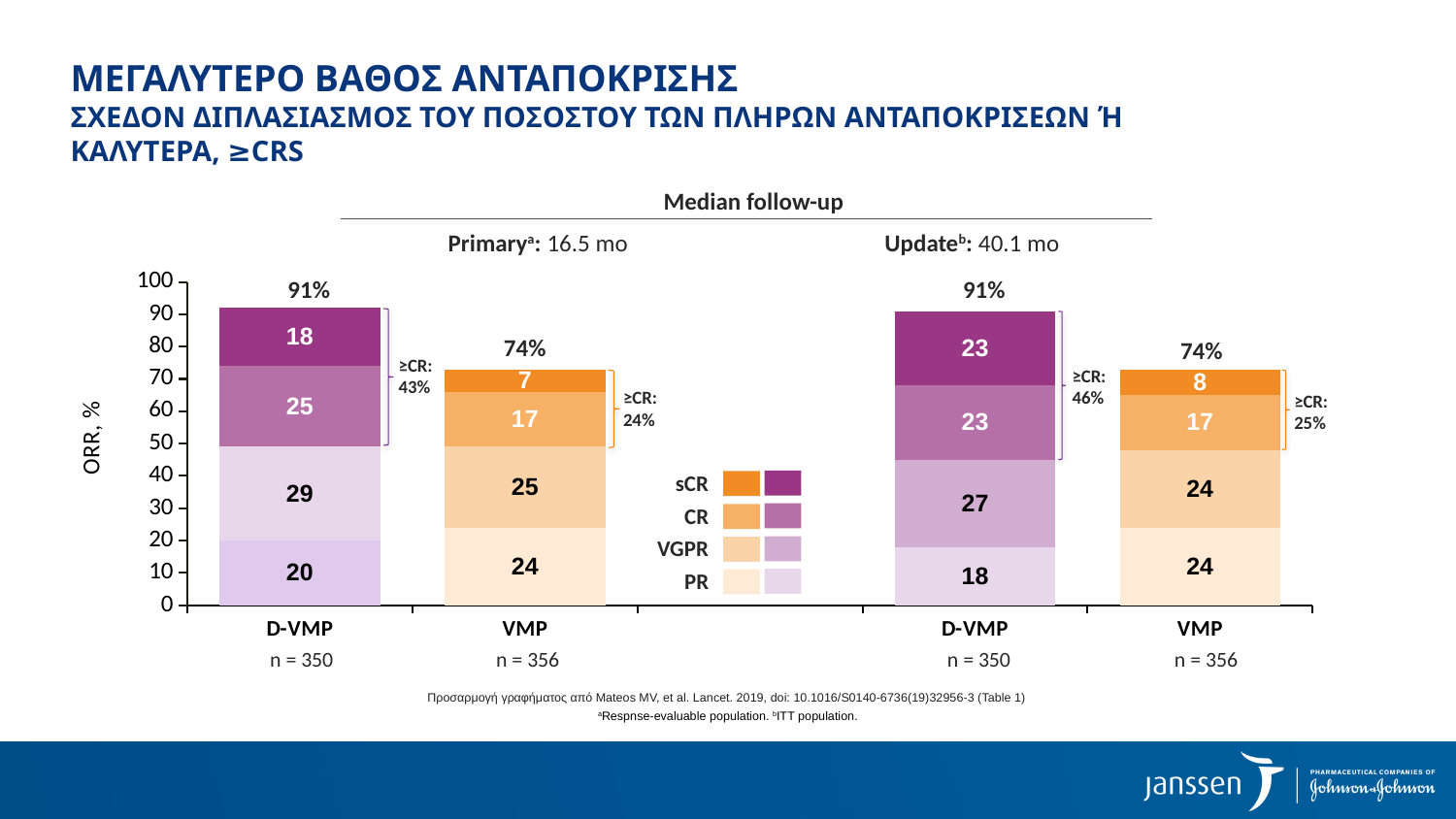
Which has the higher ORR at the update analysis (40.1 mo), D-VMP or VMP? D-VMP What is the difference in ORR between D-VMP and VMP at the primary analysis (16.5 mo)? 17% Which bar has the lowest sCR value across all four bars? VMP at the primary analysis (16.5 mo) What is the PR value for D-VMP at the update analysis (40.1 mo)? 18 What is the difference in sCR between D-VMP and VMP at the update analysis (40.1 mo)? 15 What type of chart is shown on the slide? Stacked bar chart What is the label of the y-axis? ORR, % What is the ORR for D-VMP at the primary analysis (16.5 mo median follow-up)? 91% What is the sCR value for VMP at the update analysis (40.1 mo median follow-up)? 8 What is the ≥CR rate for D-VMP at the primary analysis (16.5 mo)? 43% What is the ≥CR rate for VMP at the update analysis (40.1 mo)? 25% How many response categories does the legend list? 4